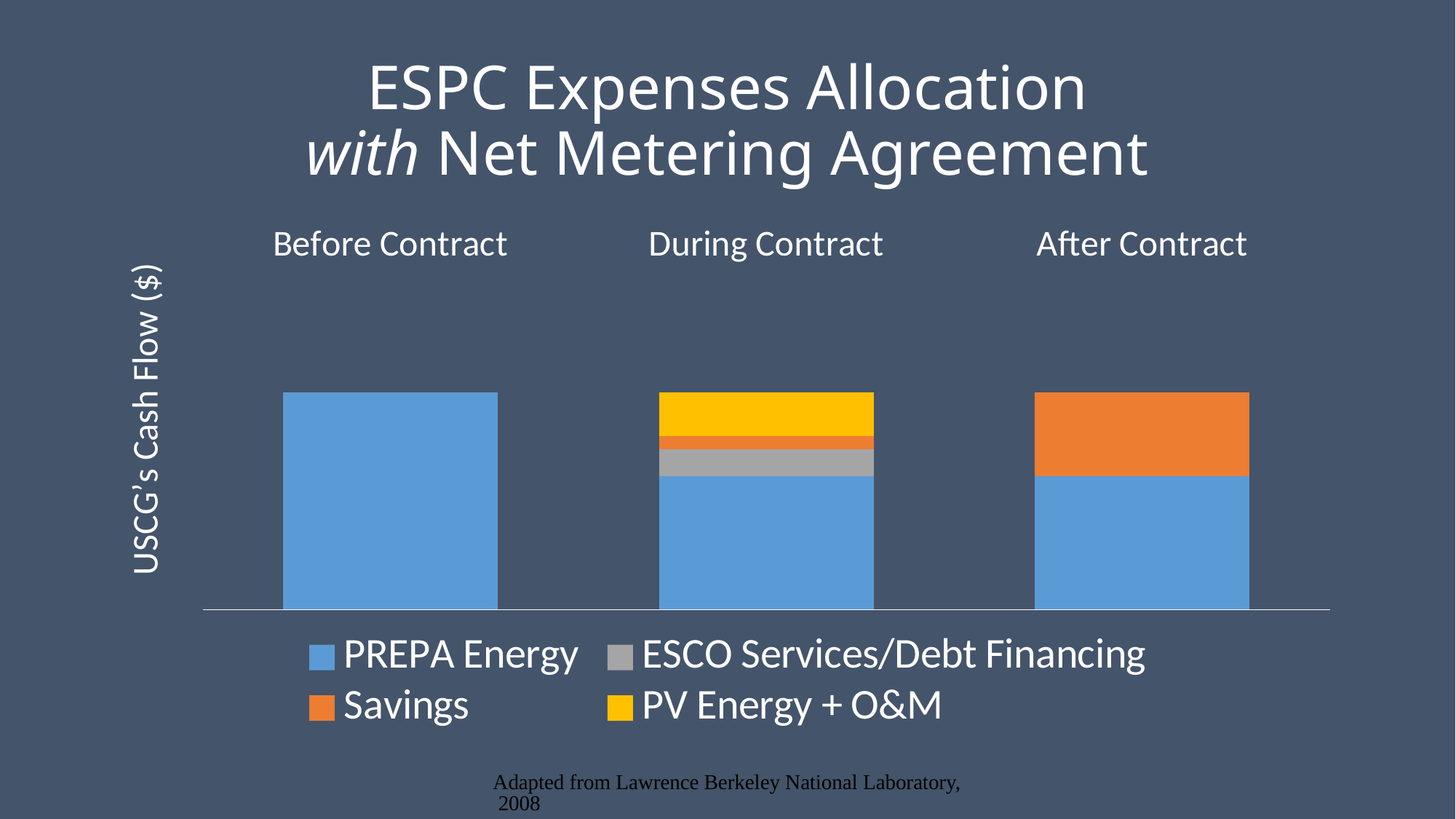
Which category's bar contains the most segments? During Contract Which series appears only in the During Contract bar and in no other bar, besides ESCO Services/Debt Financing? PV Energy + O&M How many series does the chart's legend list? 4 Which category's bar consists entirely of PREPA Energy? Before Contract How many categories are shown along the x axis of the chart? 3 Is the Savings segment larger in the During Contract bar or the After Contract bar? After Contract What is the label on the vertical axis of the chart? USCG's Cash Flow ($) What is the title of the chart on the slide? ESPC Expenses Allocation with Net Metering Agreement What kind of chart is shown on the slide? Stacked bar chart In the After Contract bar, which is larger: PREPA Energy or Savings? PREPA Energy Which category has the smallest PREPA Energy segment? During Contract and After Contract (tied) In the During Contract bar, which is larger: PREPA Energy or PV Energy + O&M? PREPA Energy